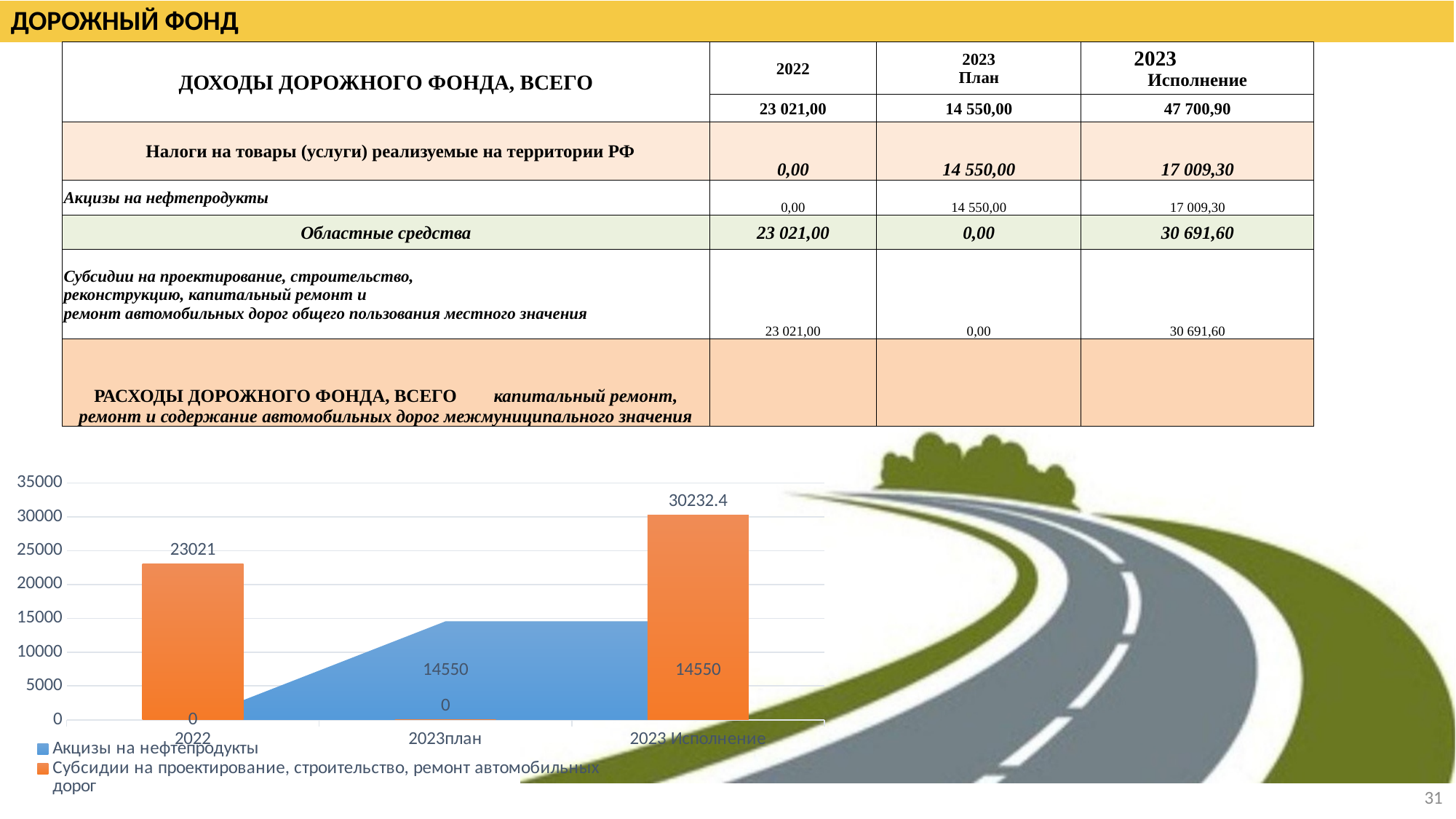
In the chart, what is the value of Акцизы на нефтепродукты for 2023план? 14550 In the chart, which is larger for 2023 Исполнение: Акцизы на нефтепродукты or Субсидии на проектирование, строительство, ремонт автомобильных дорог? Субсидии на проектирование, строительство, ремонт автомобильных дорог In the chart, what is the value of Субсидии на проектирование, строительство, ремонт автомобильных дорог for 2023 Исполнение? 30232.4 How many series does the chart legend list? 2 In the chart, what is the value of Акцизы на нефтепродукты for 2022? 0 In the chart, which category has the highest value for Субсидии на проектирование, строительство, ремонт автомобильных дорог? 2023 Исполнение How many categories are shown on the x axis of the chart? 3 In the chart, which category has the lowest value for Акцизы на нефтепродукты? 2022 In the chart, what is the difference between the Субсидии values for 2023 Исполнение and 2022? 7211.4 In the chart, what is the value of Субсидии на проектирование, строительство, ремонт автомобильных дорог for 2023план? 0 In the chart, what kind of chart is used for the Субсидии на проектирование, строительство, ремонт автомобильных дорог series? Bar chart In the chart, what is the value of Субсидии на проектирование, строительство, ремонт автомобильных дорог for 2022? 23021